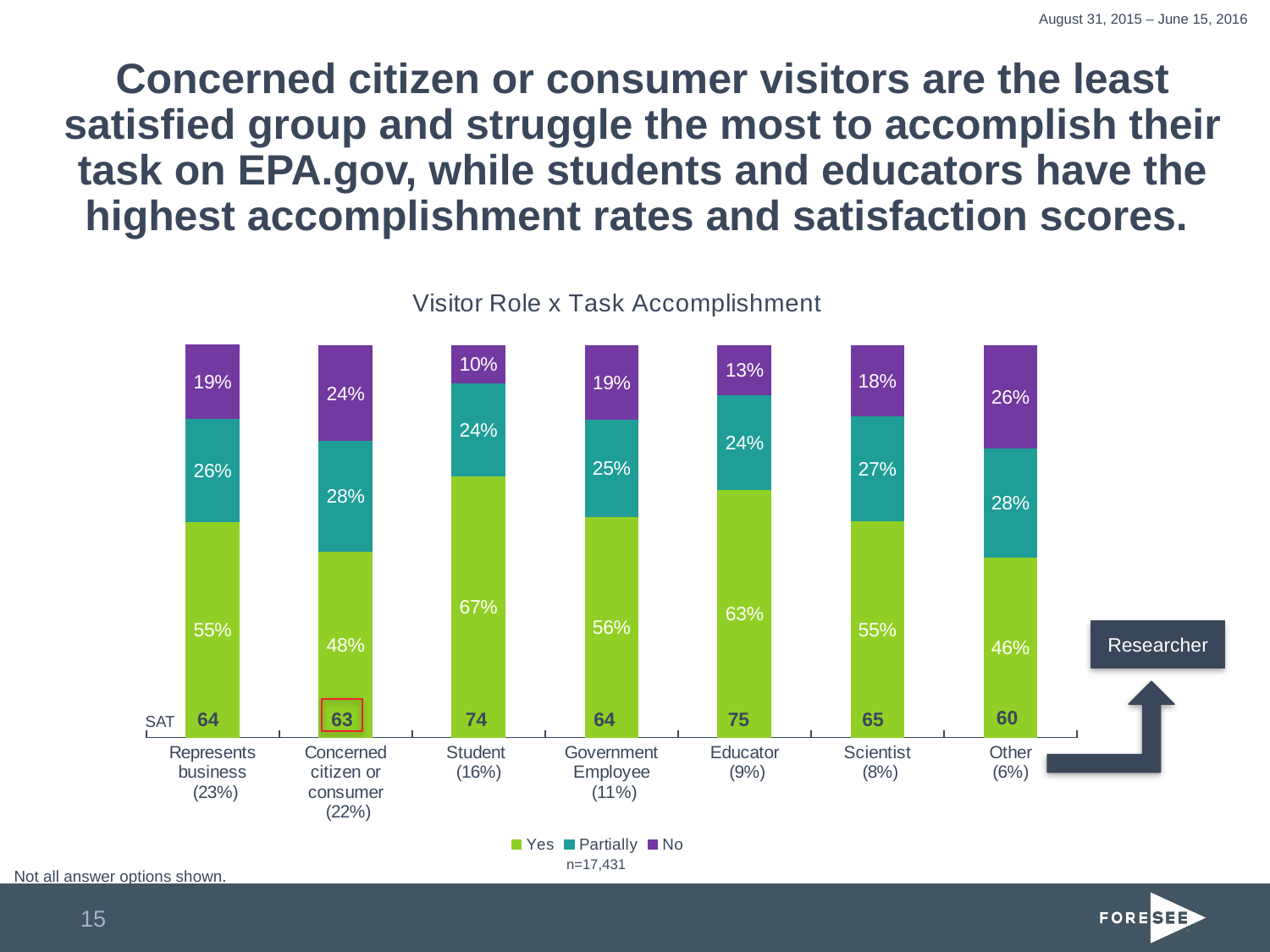
How many series does the legend list? 3 Which visitor role has the lowest SAT score? Other What is the SAT score shown for the Educator group? 75 What is the total of the three segments for the Government Employee bar? 100% Which visitor role has the highest "Yes" percentage? Student Which group has a larger "No" percentage, Other or Scientist? Other What is the title of the chart? Visitor Role x Task Accomplishment What is the difference between the "Yes" percentages for Student and Concerned citizen or consumer? 19% How many visitor role categories are shown on the x axis? 7 What is the "No" percentage for the Concerned citizen or consumer group? 24% What kind of chart is shown on the slide? Stacked bar chart What percentage of Student visitors answered "Yes" to task accomplishment? 67%